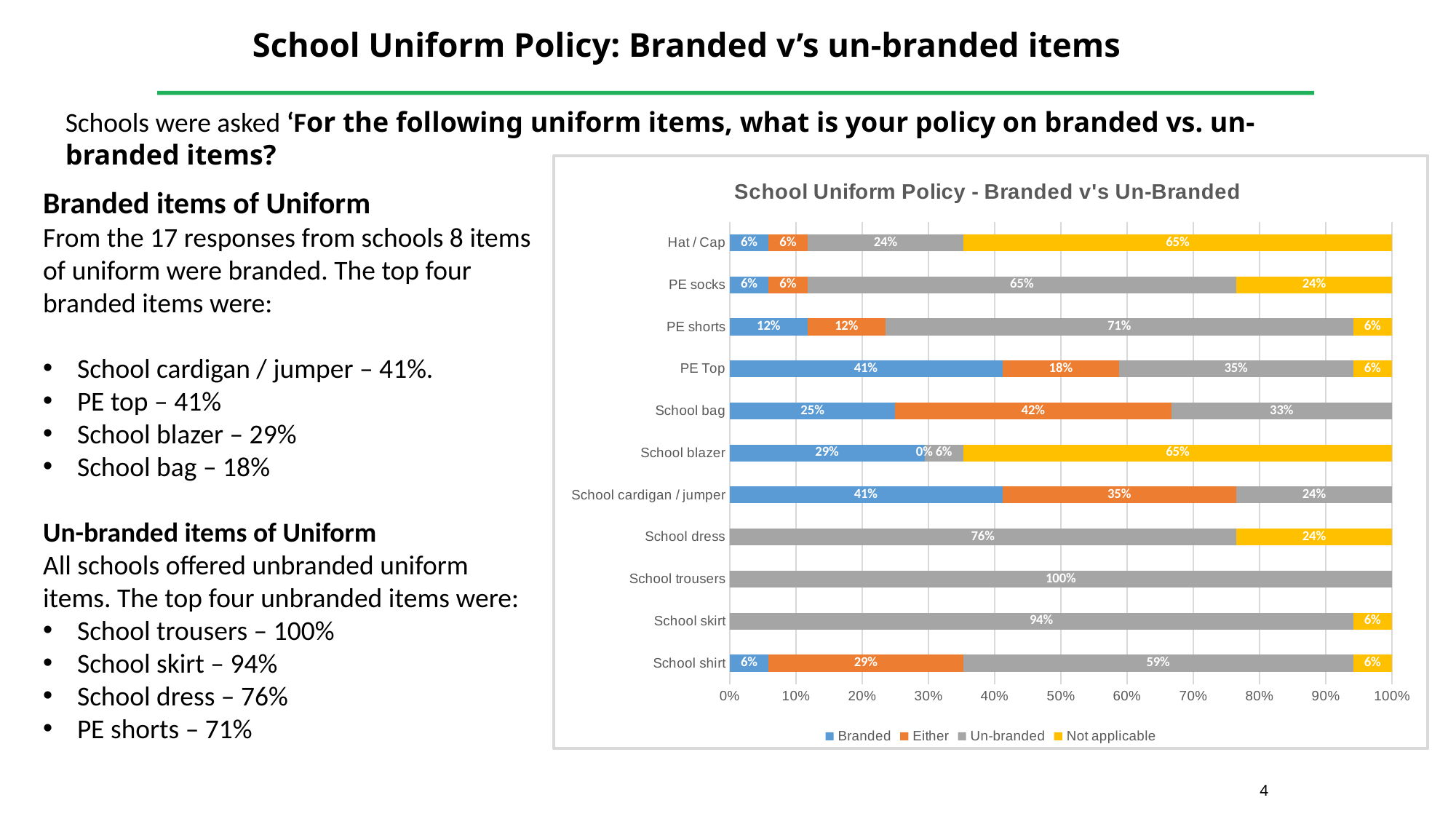
What are the four series named in the chart legend? Branded, Either, Un-branded, Not applicable What is the Un-branded value for School trousers? 100% Which has the larger Branded value, PE Top or School blazer? PE Top What is the Not applicable value for Hat / Cap? 65% How many series does the legend of the chart list? 4 What kind of chart is shown on the slide? Bar chart Which category has the lowest Un-branded value? School blazer Which category has the highest Un-branded value? School trousers What is the Branded value for School cardigan / jumper? 41% What is the difference between the Un-branded values for PE shorts and PE Top? 36 percentage points How many uniform item categories are plotted in the chart? 11 What is the Either value for School bag? 42%